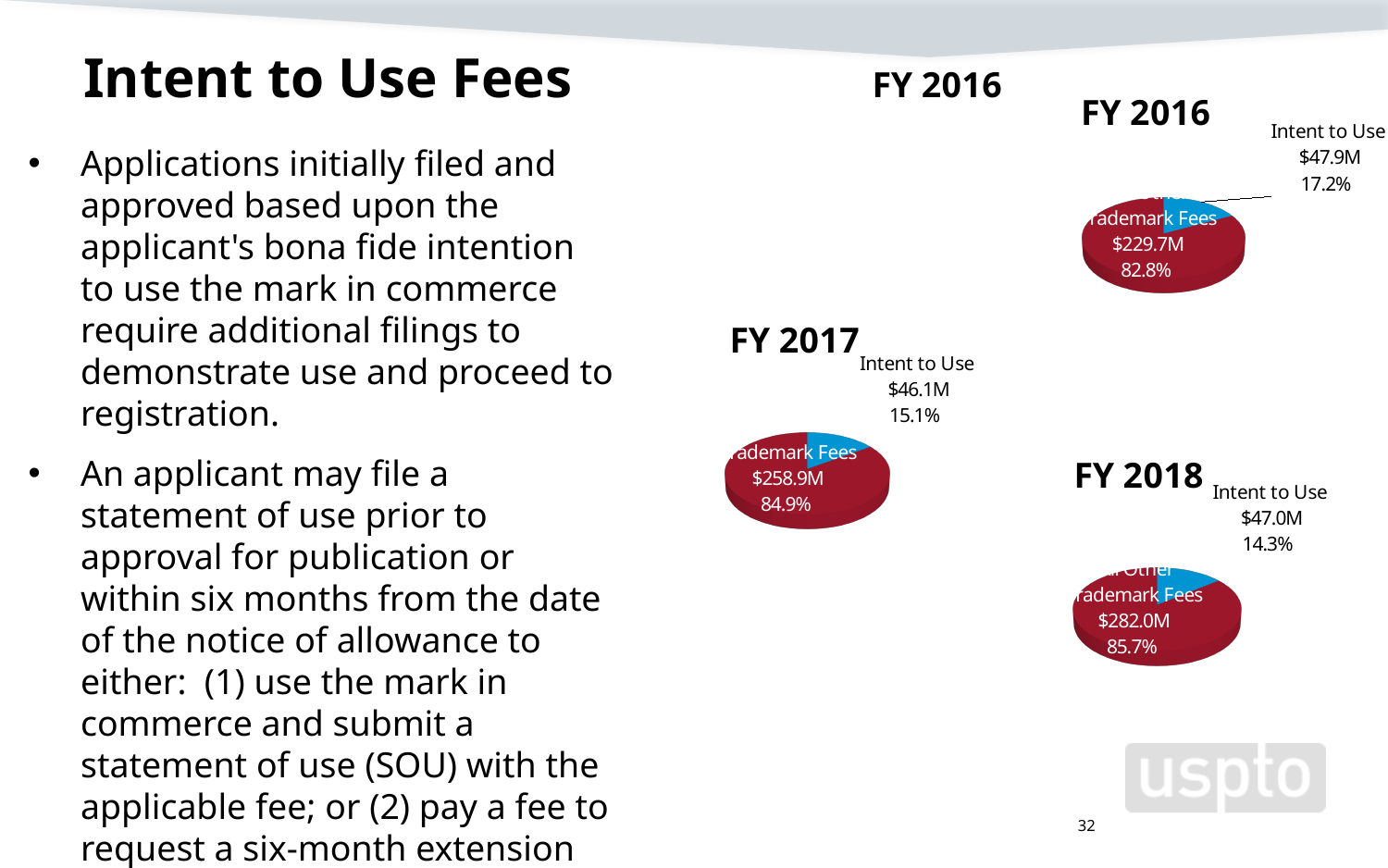
In the FY 2018 chart, what share of the pie is Intent to Use? 14.3% Across the FY 2016, FY 2017 and FY 2018 charts, which year has the highest Trademark Fees value? FY 2018 In the FY 2016 chart, what is the value for Intent to Use? $47.9M In the FY 2017 chart, what share of the pie is the Trademark Fees slice? 84.9% What kind of chart is used for FY 2016, FY 2017 and FY 2018? Pie chart How many slices does the FY 2017 pie chart have? 2 In the FY 2018 chart, what is the value for Intent to Use? $47.0M In the FY 2016 chart, what is the difference between the Trademark Fees value and the Intent to Use value? $181.8M In the FY 2016 chart, which slice is larger, Intent to Use or Trademark Fees? Trademark Fees Across the FY 2016, FY 2017 and FY 2018 charts, does the Intent to Use share rise or fall from year to year? Fall In the FY 2016 chart, what share of the pie is Intent to Use? 17.2% In the FY 2017 chart, what is the value for the Trademark Fees slice? $258.9M